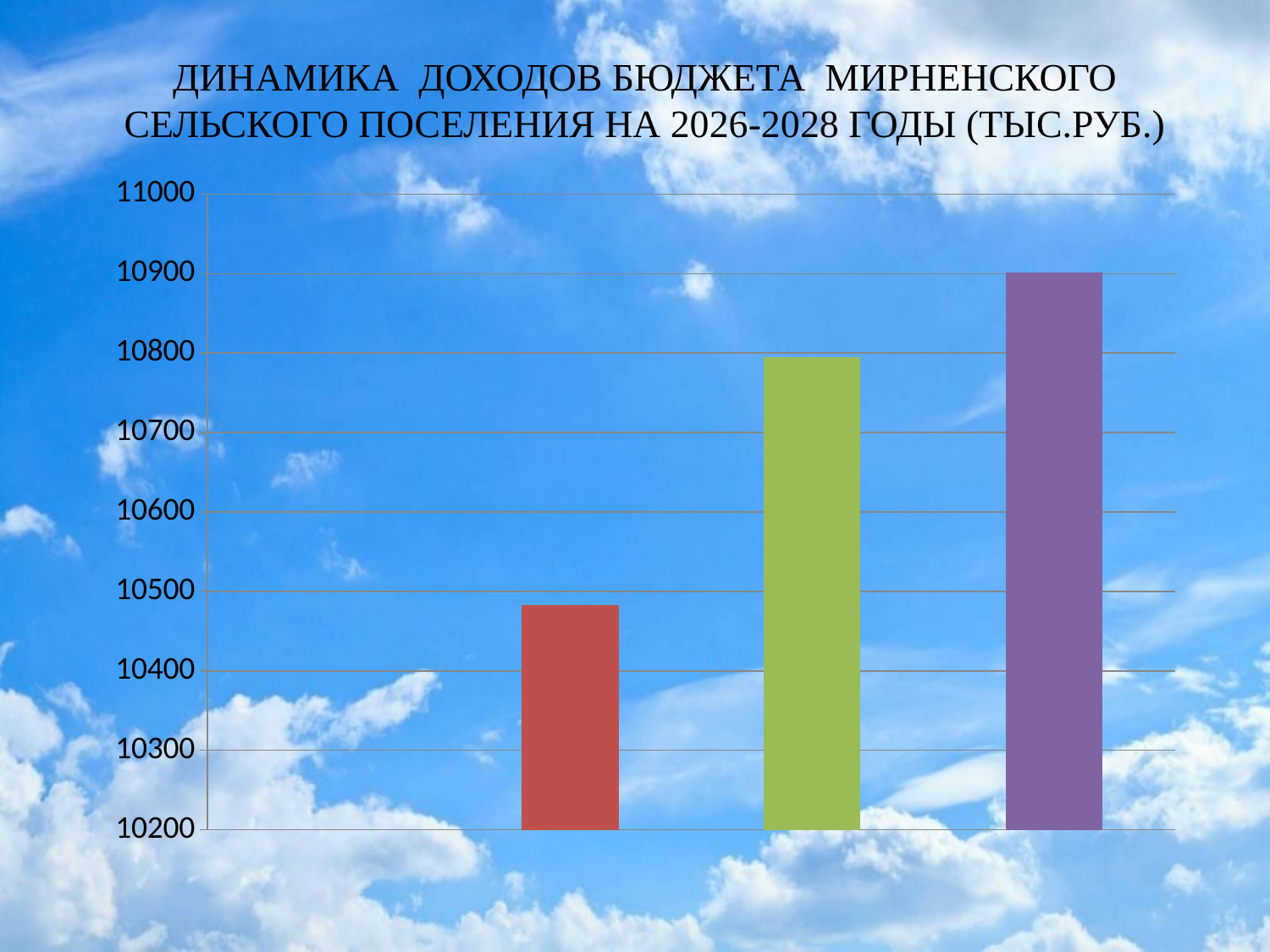
Is the value of the red (first) bar greater or less than 10400? greater Which bar is the tallest in the chart? the purple (third) bar Which bar is the shortest in the chart? the red (first) bar What kind of chart is shown on the slide? bar chart Which is larger, the green (second) bar or the red (first) bar? the green (second) bar Do the bar values rise or fall from left to right across the chart? rise Is the value of the purple (third) bar greater or less than 10800? greater Which years does the chart title say the budget revenue dynamics cover? 2026-2028 How many bars are plotted in the chart? 3 Is the value of the green (second) bar greater or less than 10700? greater What unit of measurement is stated in the chart title? ТЫС.РУБ.